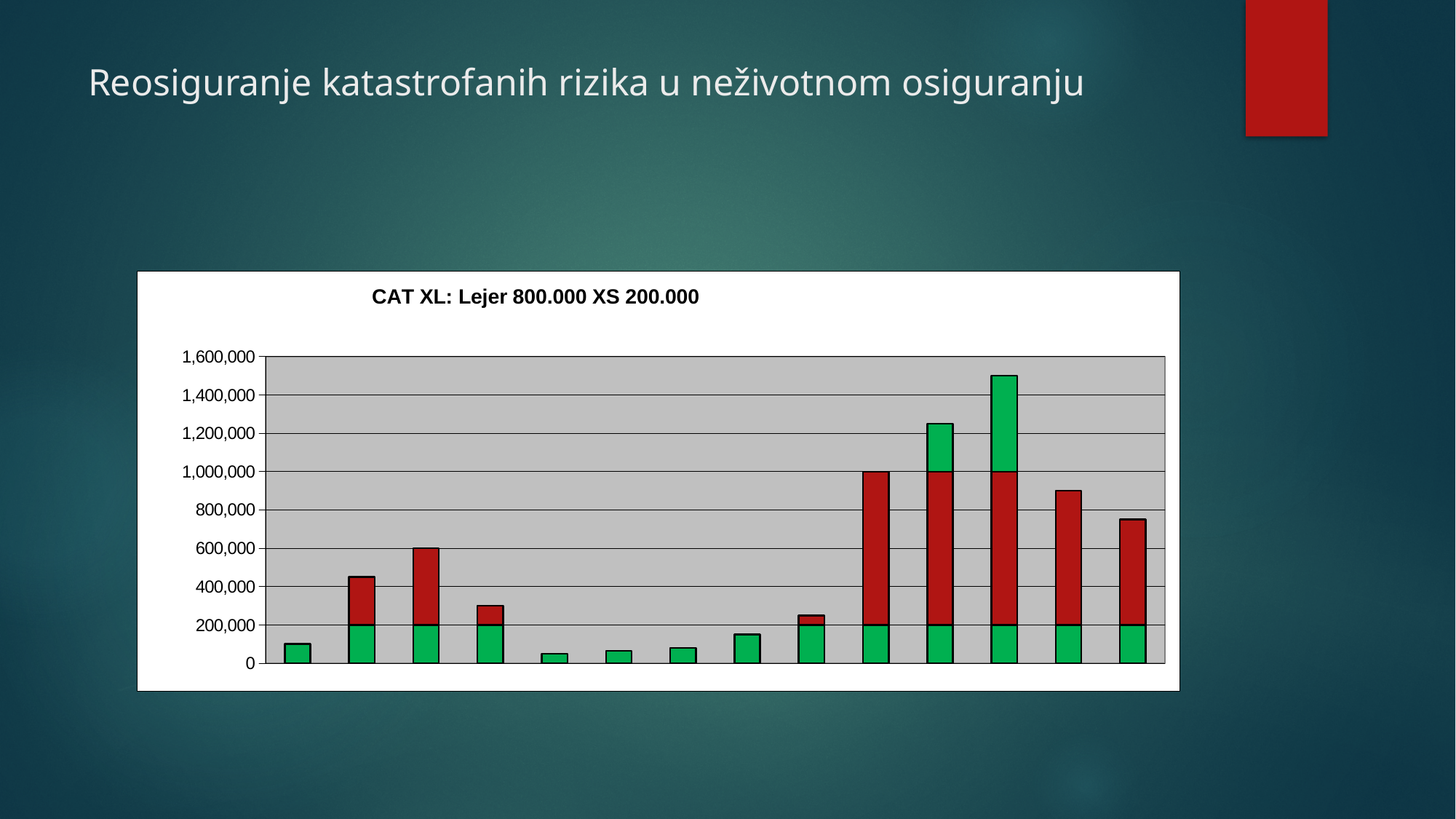
Is the total of the last bar on the right greater or less than 800,000? less Which is taller, the second bar from the left or the third bar from the left? The third bar from the left What is the total height of the third bar from the left? 600,000 Is the total of the first bar from the left greater or less than 200,000? less Is the total of the twelfth bar from the left greater or less than 1,400,000? greater Which bar is the tallest in the chart? The twelfth bar from the left (third from the right) What is the title of the chart? CAT XL: Lejer 800.000 XS 200.000 What two colours are used for the bar segments in the chart? Green and red What kind of chart is shown on the slide? Stacked bar chart Which bar is the shortest in the chart? The fifth bar from the left What is the total height of the tenth bar from the left? 1,000,000 How many bars are plotted in the chart? 14